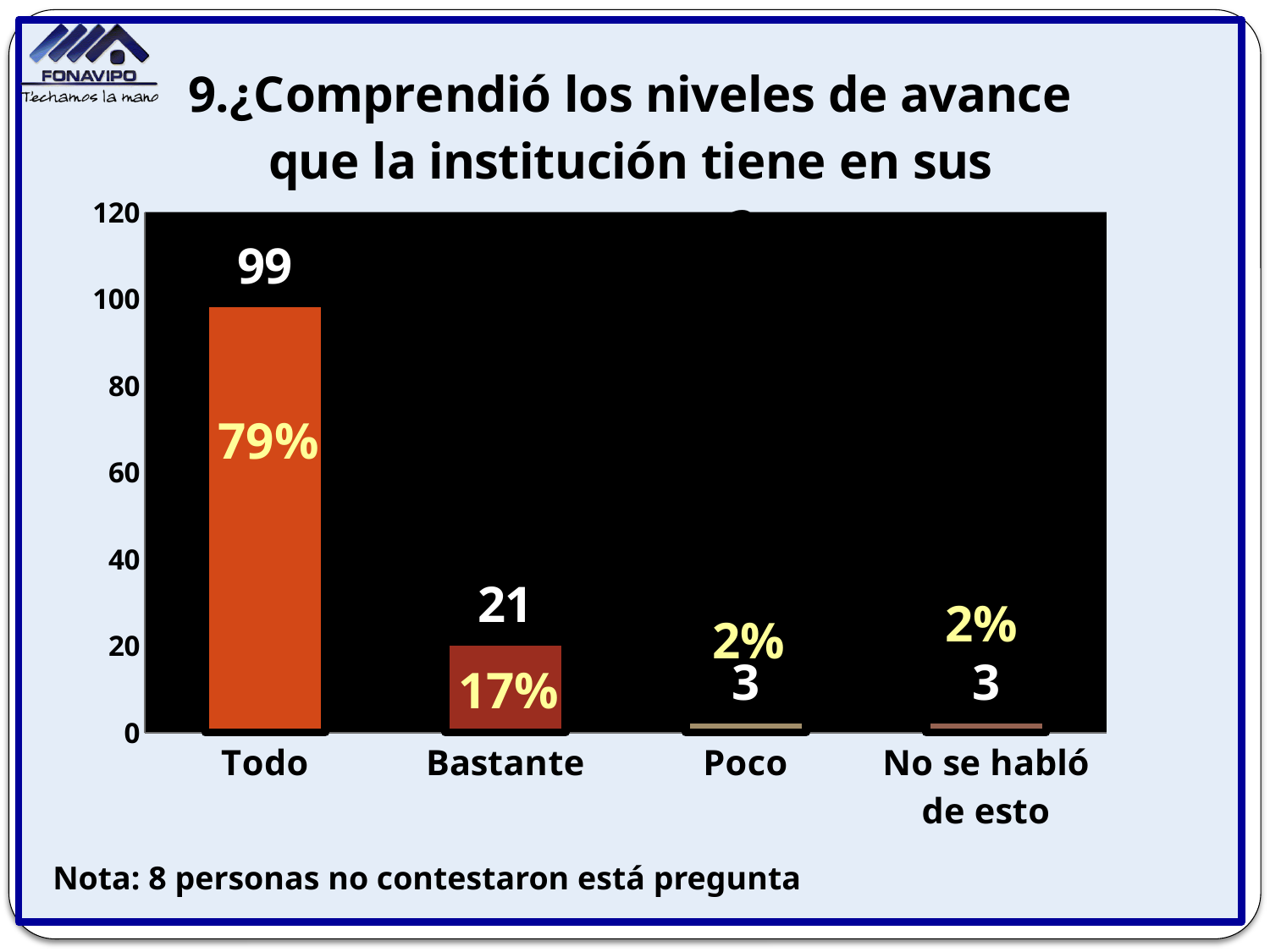
How many categories are shown on the x axis? 4 Which category has the highest value? Todo What is the value for Bastante? 21 What is the background colour of the chart's plot area? black What is the difference between the values for Todo and Bastante? 78 Is the value for Todo greater or less than 80? greater Which is larger, the value for Bastante or the value for Poco? Bastante What kind of chart is shown on the slide? bar chart What is the value for Todo? 99 What percentage is shown for Bastante? 17% What percentage is shown for Todo? 79% What is the value for Poco? 3